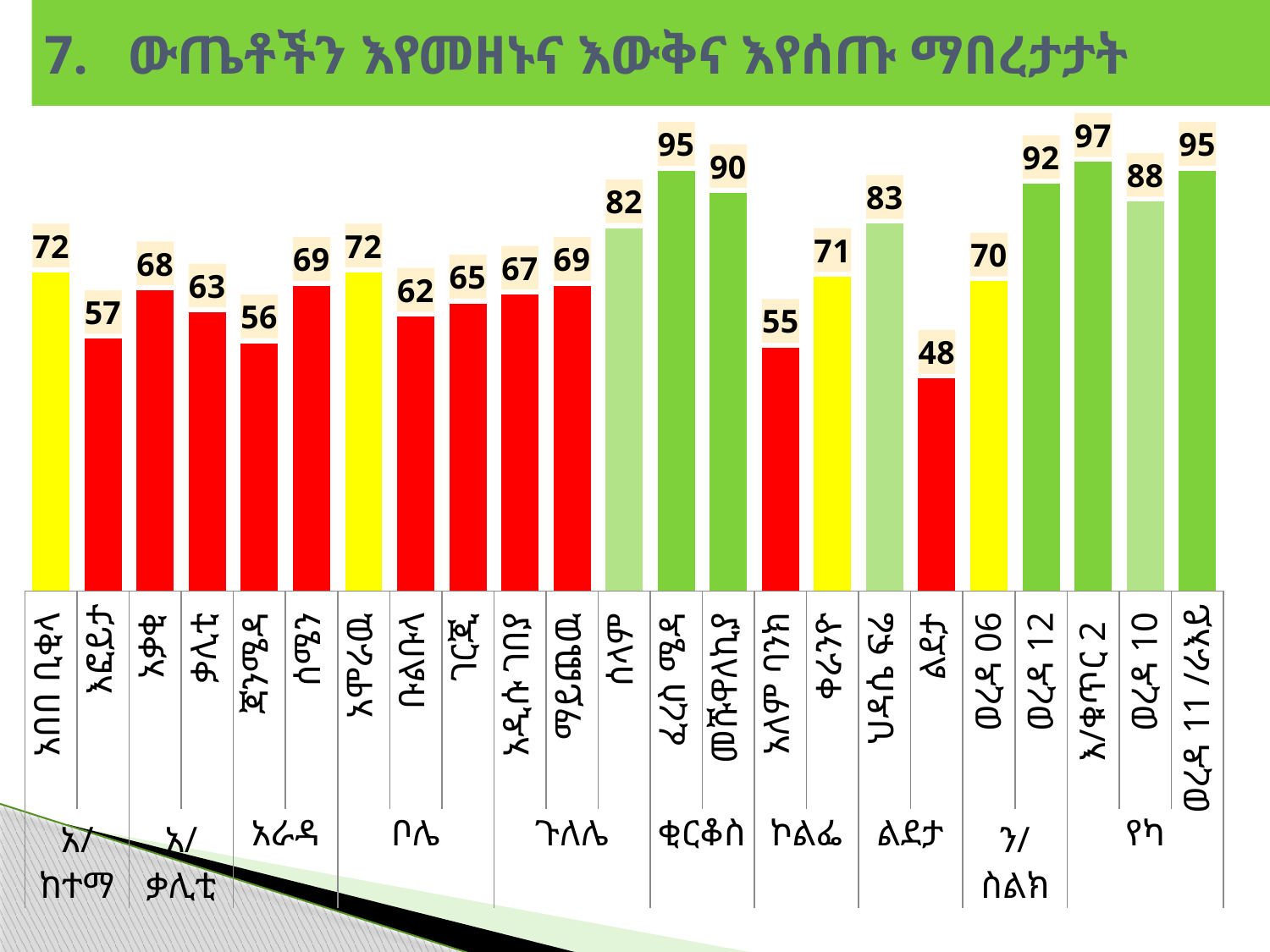
What is the value for ወረዳ 10? 88 Which category has the lowest value? ልደታ What is the value for ልደታ? 48 What is the difference between the values for ወረዳ 12 and ወረዳ 06? 22 What kind of chart is shown on the slide? bar chart What is the value for ሰላም? 82 Which has a larger value, አቃቂ or ቃሊቲ? አቃቂ What is the value for ቀራንዮ? 71 Which category has the highest value? እ/ቁጥር 2 What is the value for ወረዳ 12? 92 How many bars are plotted in the chart? 23 What colour is the bar for ልደታ? red